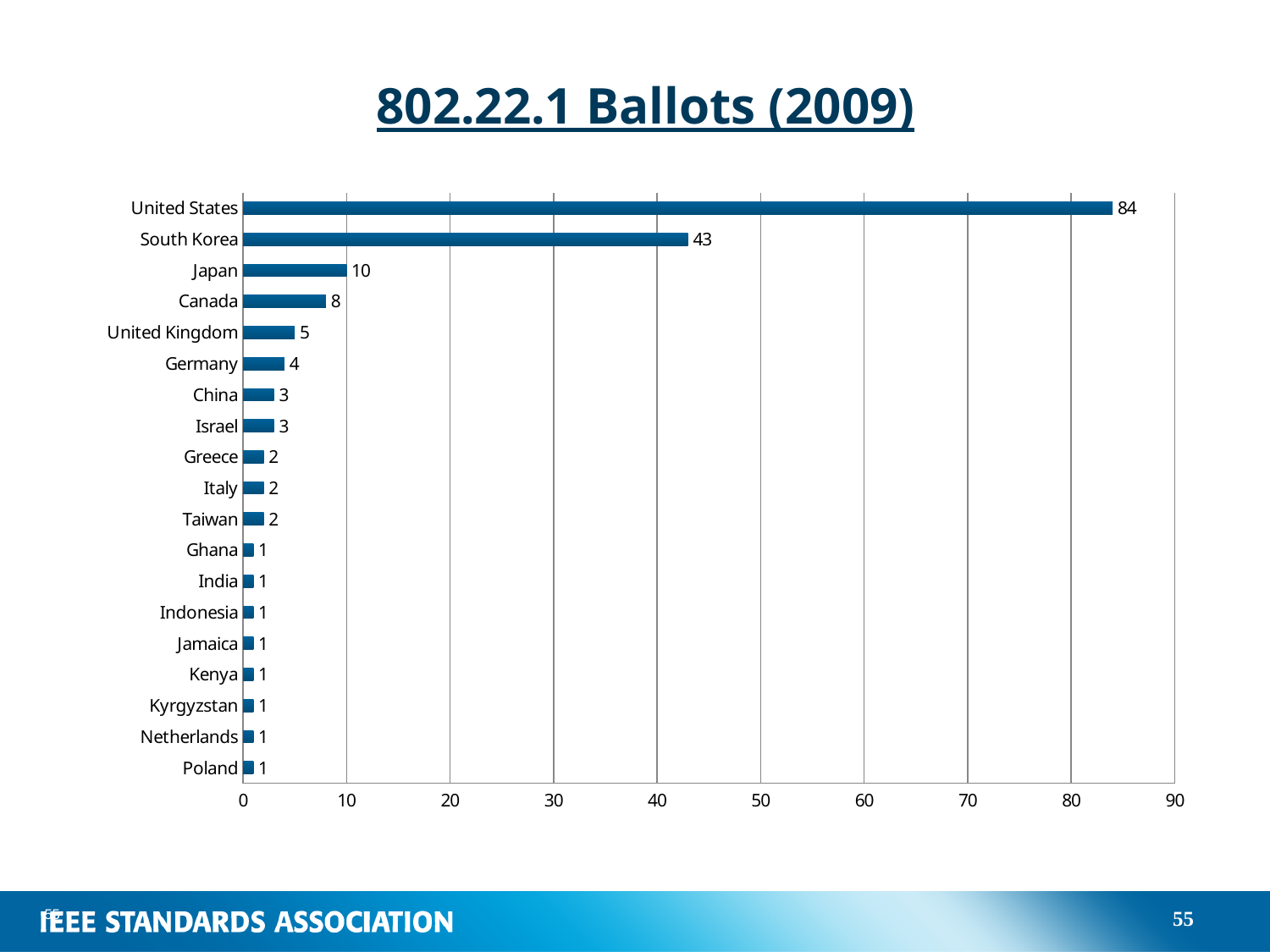
What is the value for United States? 84 What is the difference between the values for United States and South Korea? 41 What is the title of the chart? 802.22.1 Ballots (2009) What is the difference between the values for United Kingdom and Germany? 1 Is the value for South Korea greater or less than 40? greater Which country has the highest value? United States Which has a larger value, Japan or Canada? Japan What is the value for South Korea? 43 What is the value for Canada? 8 How many countries are shown in the chart? 19 What is the value for Japan? 10 What kind of chart is shown on the slide? bar chart